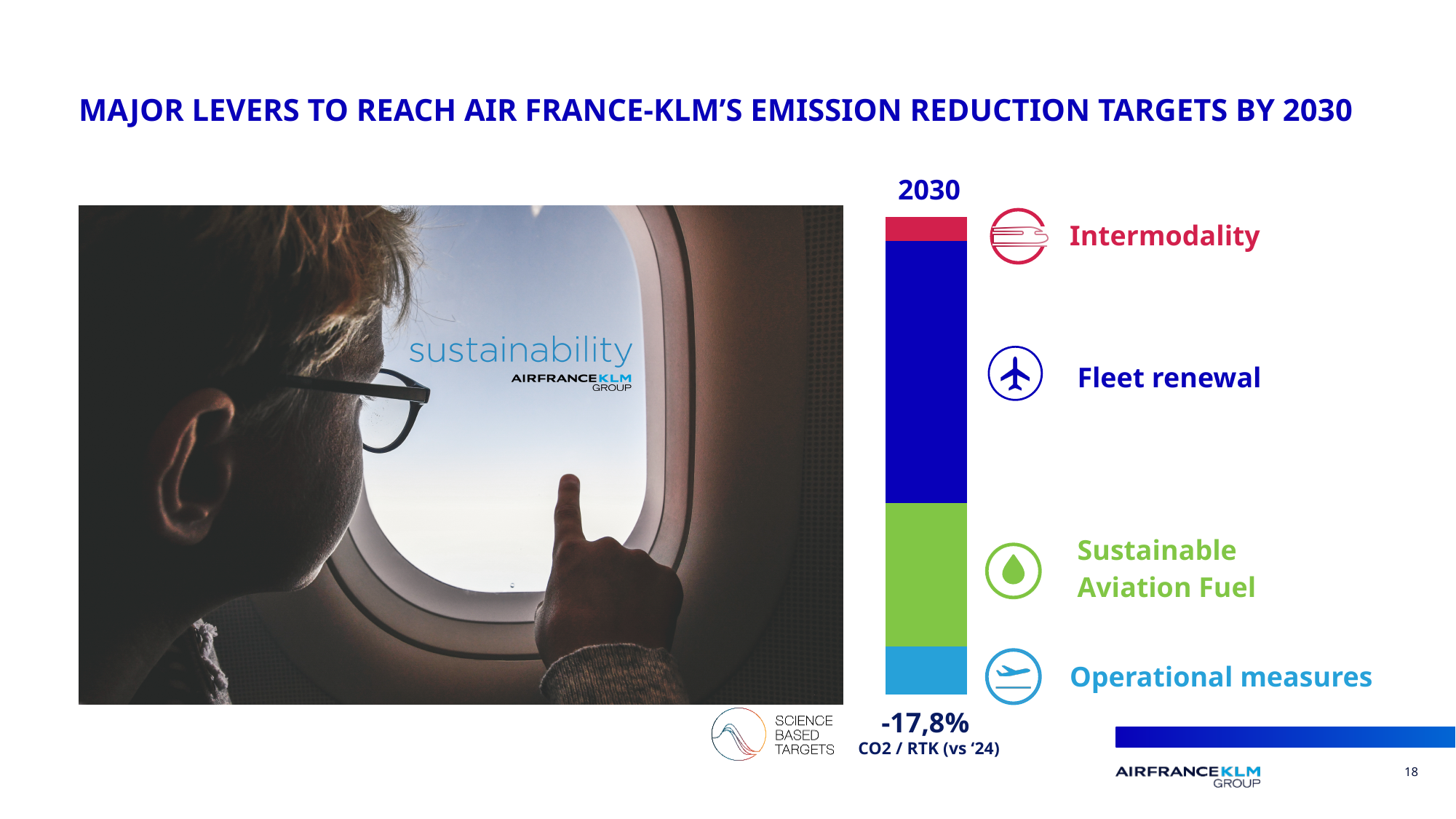
What metric is the -17,8% reduction expressed in, according to the label under the bar? CO2 / RTK (vs '24) Which lever accounts for the smallest segment of the 2030 bar? Intermodality What kind of chart is shown on the slide? stacked bar chart What year is labelled above the stacked bar? 2030 Which lever accounts for the largest segment of the 2030 bar? Fleet renewal Which segment is larger: Sustainable Aviation Fuel or Operational measures? Sustainable Aviation Fuel What colour is the Sustainable Aviation Fuel segment of the bar? green Which segment is larger: Operational measures or Intermodality? Operational measures Which segment is larger: Fleet renewal or Sustainable Aviation Fuel? Fleet renewal How many segments (levers) make up the stacked bar? 4 Which lever is shown at the bottom of the stacked bar? Operational measures What total emission reduction is printed below the stacked bar? -17,8%